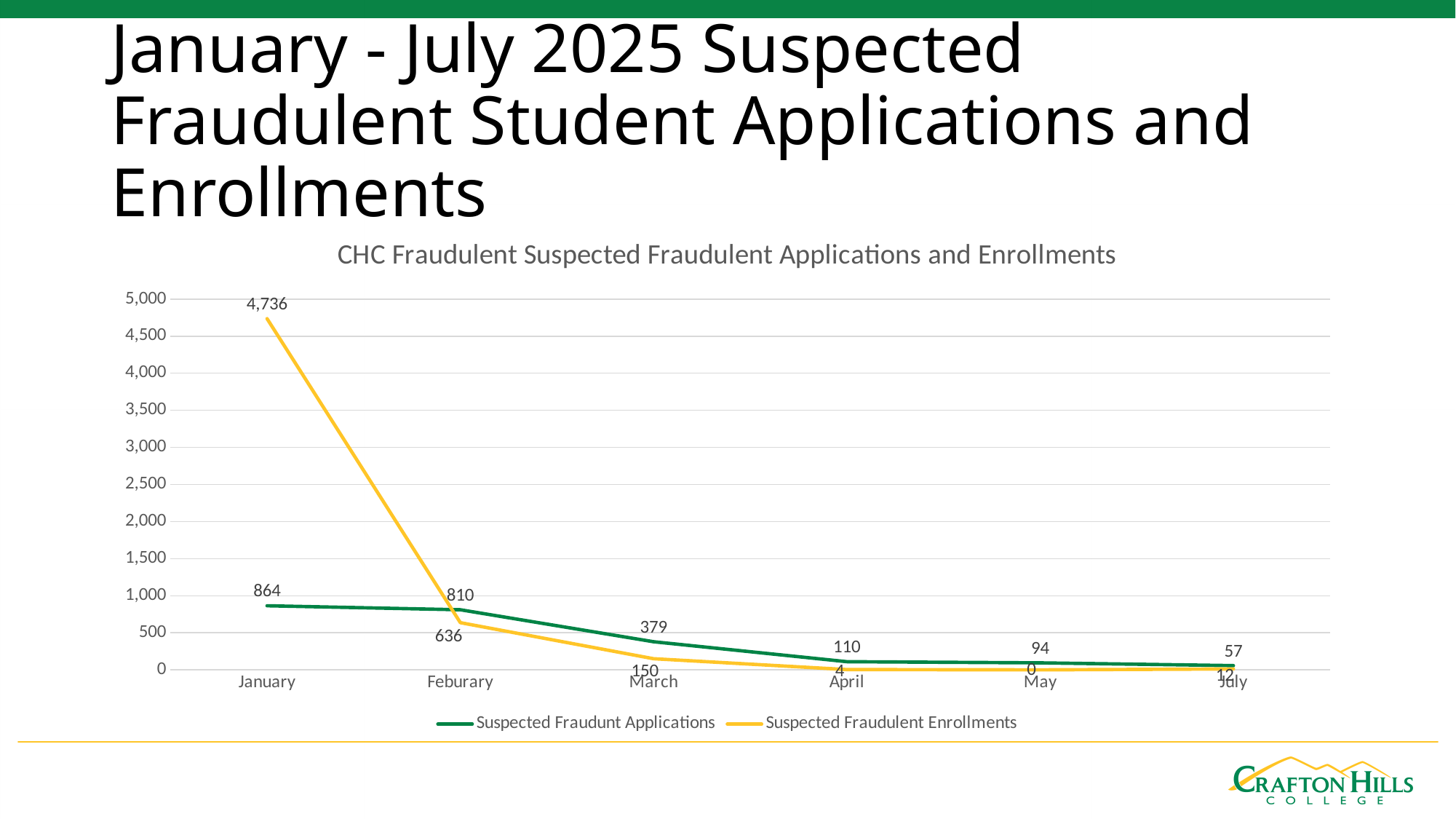
What kind of chart is shown on the slide? line chart In which month is Suspected Fraudulent Enrollments highest? January Which is larger in Feburary: Suspected Fraudunt Applications or Suspected Fraudulent Enrollments? Suspected Fraudunt Applications What is the value for Suspected Fraudunt Applications in July? 57 What is the value for Suspected Fraudulent Enrollments in January? 4,736 What is the value for Suspected Fraudulent Enrollments in May? 0 What is the value for Suspected Fraudunt Applications in March? 379 Does Suspected Fraudulent Enrollments rise or fall from January to April? fall What is the difference between Suspected Fraudunt Applications in January and in Feburary? 54 How many series does the legend list? 2 How many months are plotted on the x axis? 6 In which month is Suspected Fraudunt Applications lowest? July